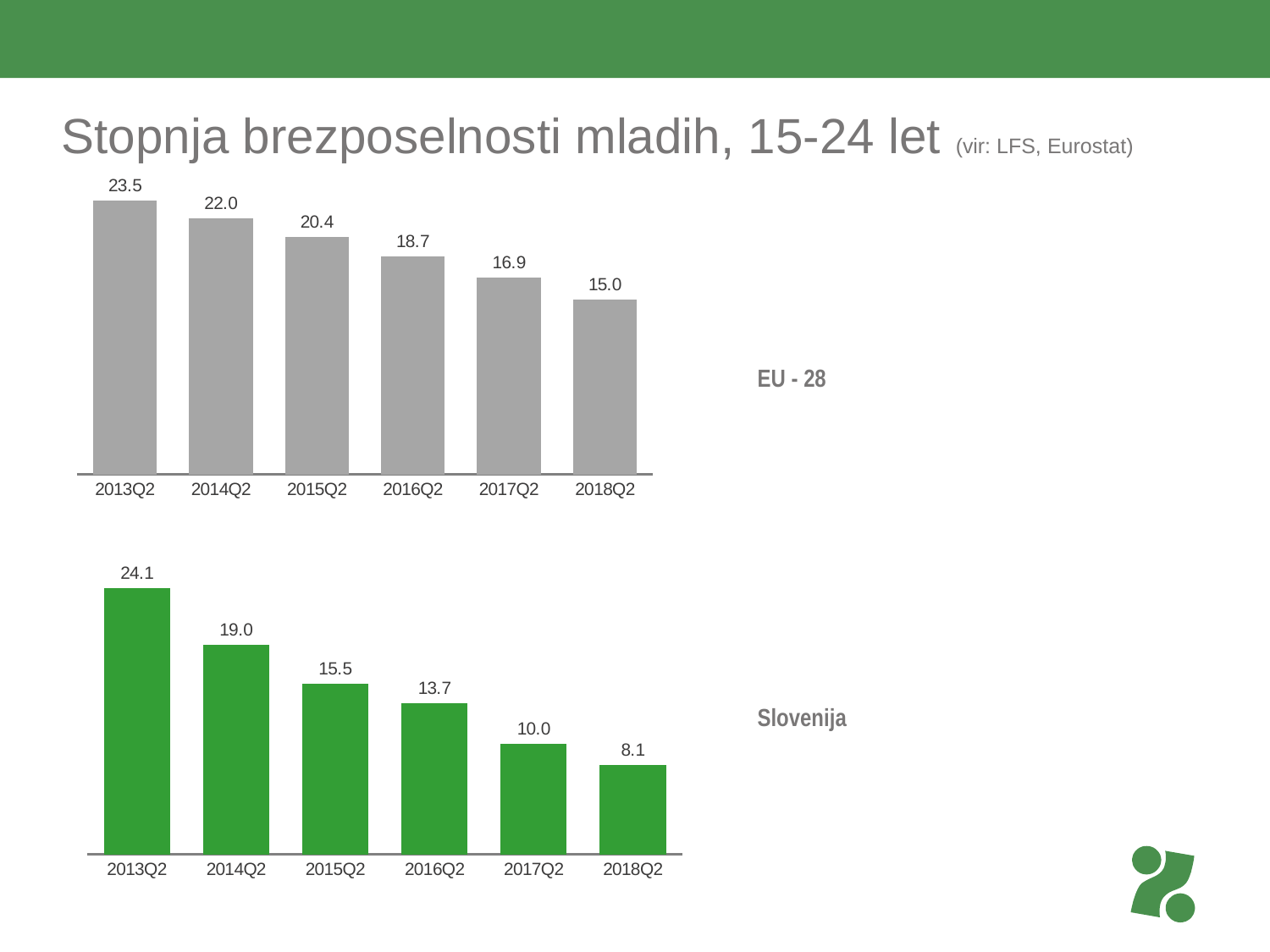
In the Slovenija chart (bottom), what is the difference between the 2013Q2 and 2018Q2 values? 16.0 Which is larger: the 2017Q2 value in the EU - 28 chart (top) or the 2017Q2 value in the Slovenija chart (bottom)? EU - 28 What colour are the bars in the Slovenija chart (bottom)? Green In the Slovenija chart (bottom), which quarter has the highest value? 2013Q2 What kind of chart is the EU - 28 chart (top)? Bar chart In the Slovenija chart (bottom), do the values rise or fall from 2013Q2 to 2018Q2? Fall In the EU - 28 chart (top), what is the value for 2016Q2? 18.7 In the EU - 28 chart (top), which quarter has the lowest value? 2018Q2 In the Slovenija chart (bottom), what is the value for 2018Q2? 8.1 In the EU - 28 chart (top), what is the difference between the 2014Q2 and 2015Q2 values? 1.6 In the EU - 28 chart (top), what is the value for 2013Q2? 23.5 How many quarters are shown in the Slovenija chart (bottom)? 6